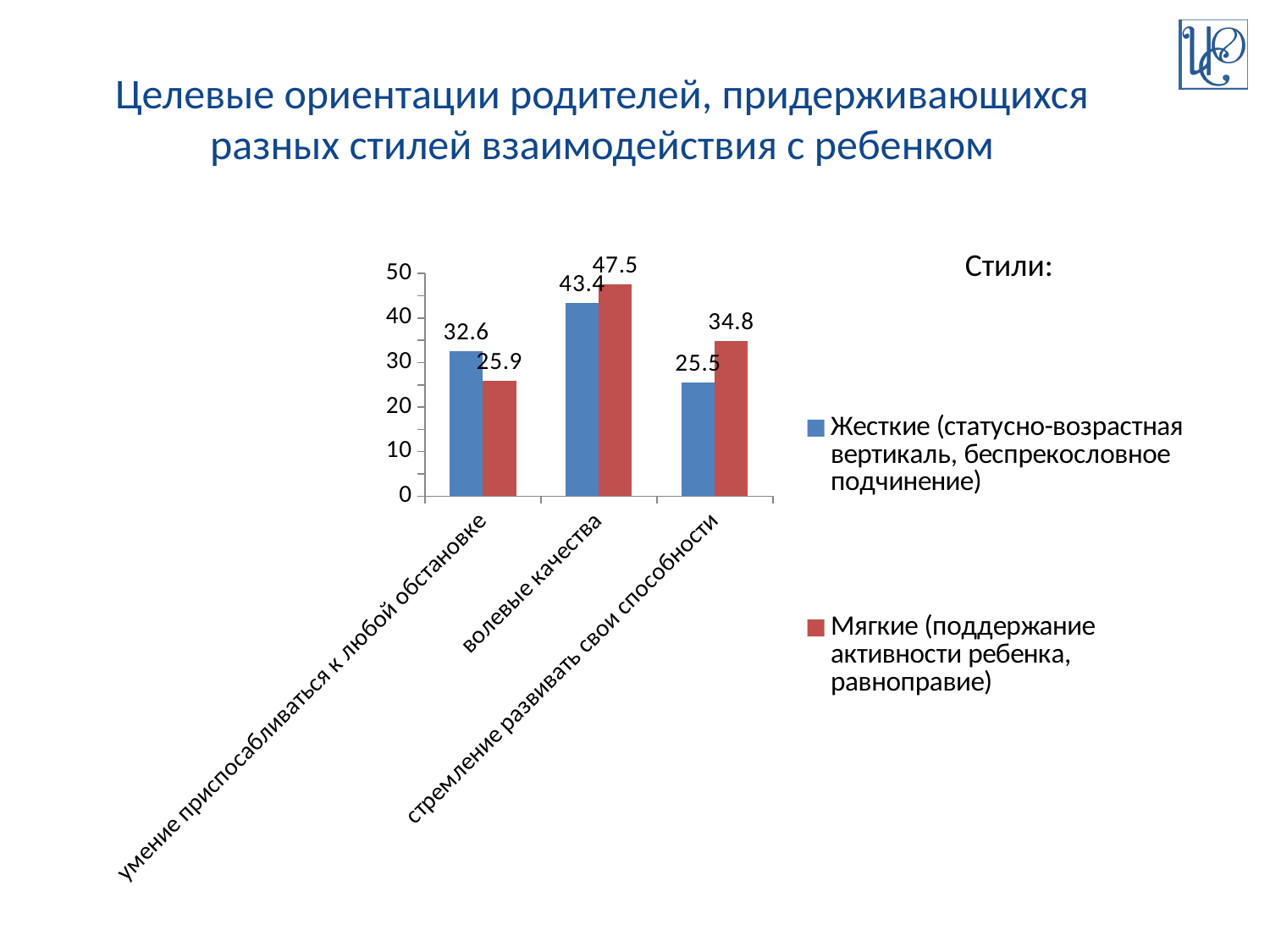
Which category has the highest value in the 'Мягкие' series? волевые качества How many categories are shown on the x axis? 3 What value is shown for 'умение приспосабливаться к любой обстановке' in the 'Жесткие' series? 32.6 How many series does the legend list? 2 Which category has the lowest value in the 'Жесткие' series? стремление развивать свои способности What colour represents the 'Мягкие' series? red Is the 'Мягкие' value for 'стремление развивать свои способности' greater or less than 30? greater What kind of chart is shown on the slide? bar chart What is the difference between the 'Мягкие' and 'Жесткие' values for 'волевые качества'? 4.1 What value is shown for 'волевые качества' in the 'Жесткие' series? 43.4 What value is shown for 'стремление развивать свои способности' in the 'Мягкие' series? 34.8 For 'умение приспосабливаться к любой обстановке', which series has the larger value, 'Жесткие' or 'Мягкие'? Жесткие